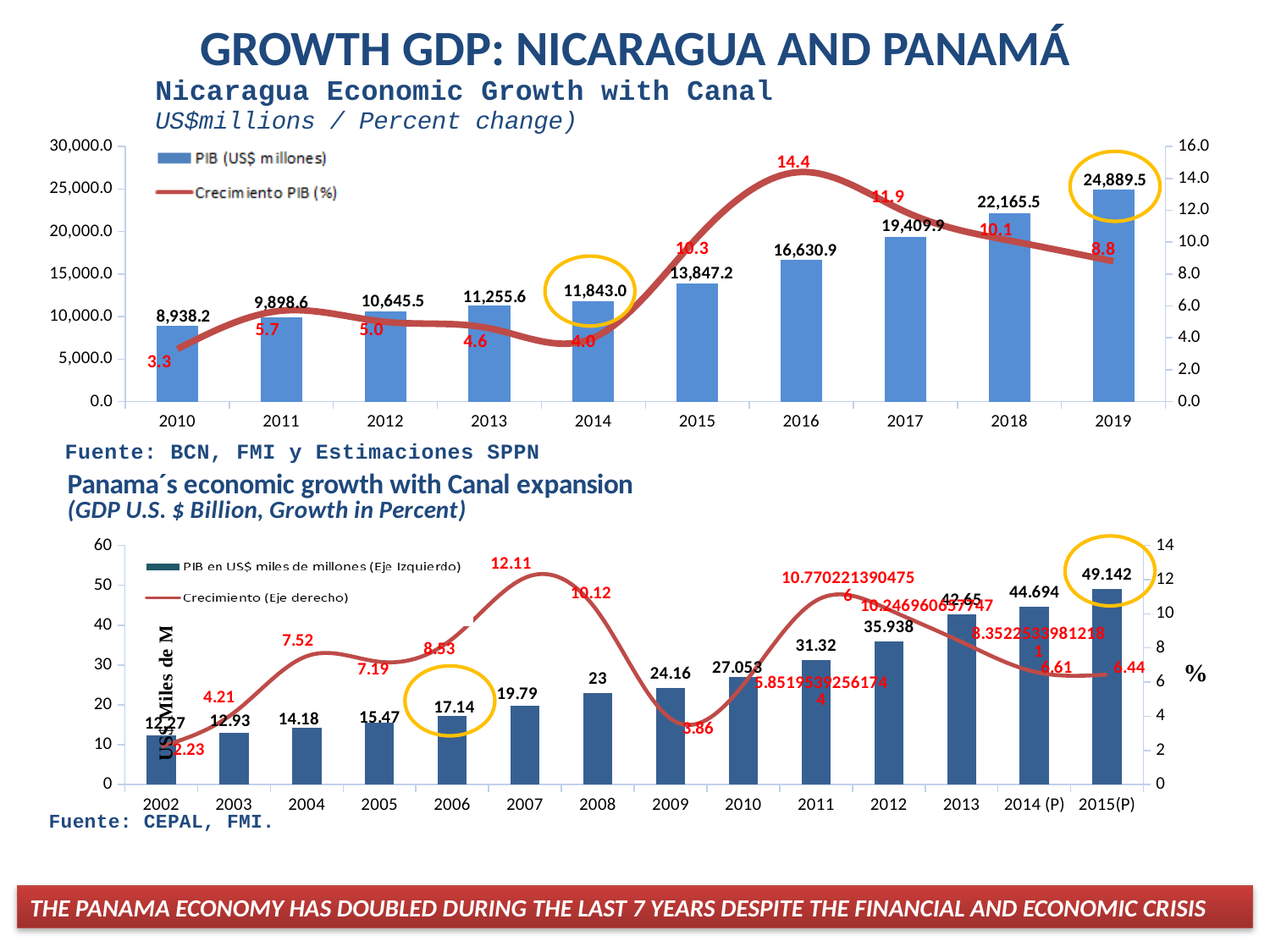
In the Nicaragua Economic Growth with Canal chart, which year has the lowest PIB (US$ millones) value? 2010 In the Panama's economic growth with Canal expansion chart, which is larger, the GDP value for 2008 or for 2009? 2009 In the Panama's economic growth with Canal expansion chart, what is the difference between the GDP values for 2015(P) and 2014 (P)? 4.448 In the Panama's economic growth with Canal expansion chart, what is the GDP value for 2006? 17.14 In the Nicaragua Economic Growth with Canal chart, what is the Crecimiento PIB (%) value for 2016? 14.4 In the Panama's economic growth with Canal expansion chart, which year has the highest GDP bar? 2015(P) In the Nicaragua Economic Growth with Canal chart, what is the difference between the PIB values for 2019 and 2018? 2,724.0 In the Nicaragua Economic Growth with Canal chart, how many years are shown on the x axis? 10 In the Nicaragua Economic Growth with Canal chart, do the PIB bar values rise or fall from 2010 to 2019? rise In the Nicaragua Economic Growth with Canal chart, what is the PIB (US$ millones) value for 2019? 24,889.5 In the Nicaragua Economic Growth with Canal chart, how many series does the legend list? 2 In the Panama's economic growth with Canal expansion chart, what is the growth value for 2007? 12.11